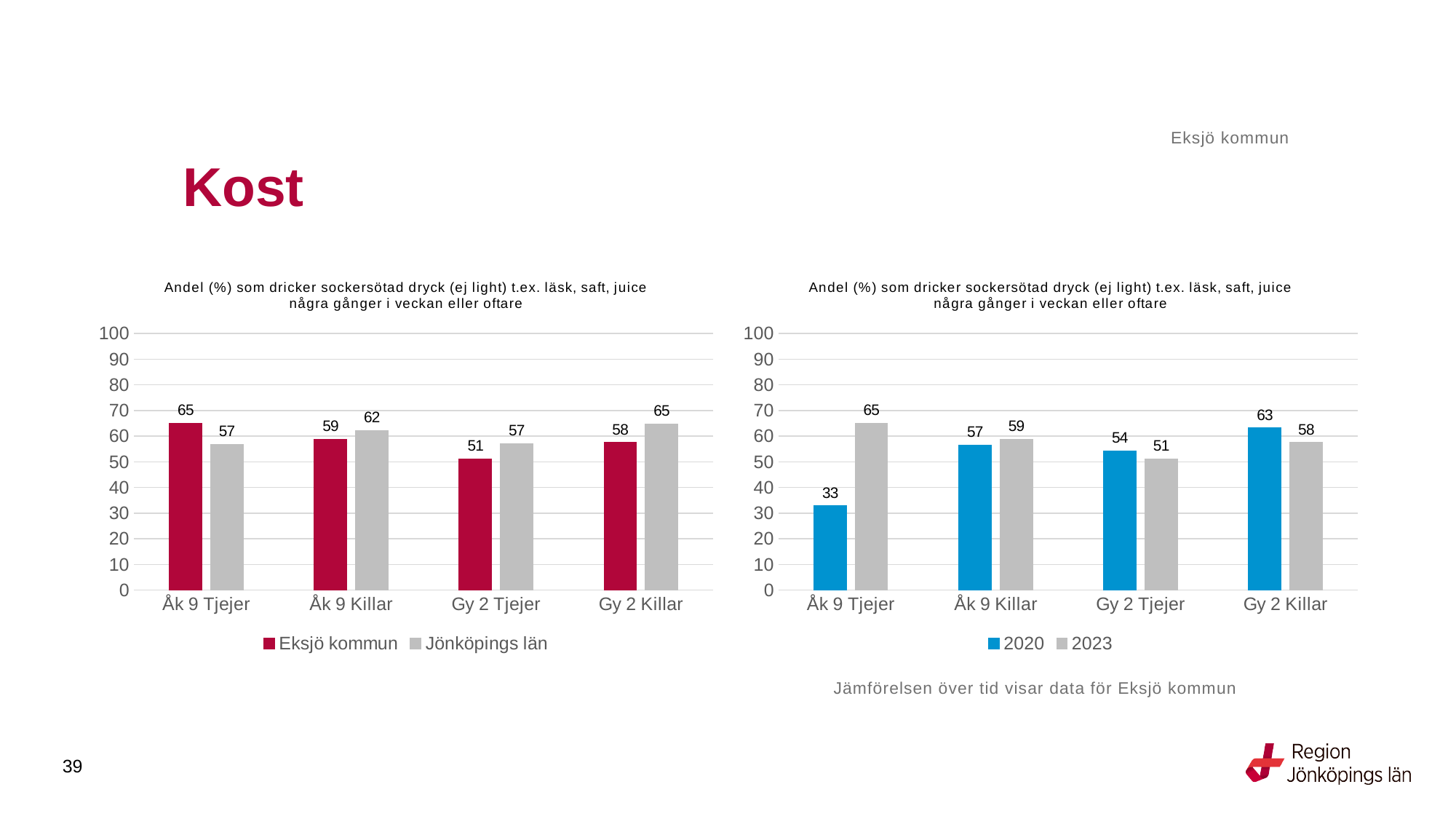
In the left chart, what is the difference between Jönköpings län and Eksjö kommun for Gy 2 Killar? 7 In the right chart, which category has the highest value for 2020? Gy 2 Killar In the left chart, which category has the lowest value for Eksjö kommun? Gy 2 Tjejer What kind of chart is the right chart? Bar chart How many categories are shown on the x axis of the left chart? 4 In the left chart, which is larger for Åk 9 Killar: Eksjö kommun or Jönköpings län? Jönköpings län In the right chart, what is the difference between 2023 and 2020 for Åk 9 Tjejer? 32 In the left chart, what is the value for Eksjö kommun for Åk 9 Tjejer? 65 In the left chart, what is the value for Jönköpings län for Gy 2 Killar? 65 In the right chart, what is the value for 2020 for Åk 9 Tjejer? 33 In the right chart, what is the value for 2023 for Gy 2 Tjejer? 51 In the right chart, which is larger for Gy 2 Killar: 2020 or 2023? 2020